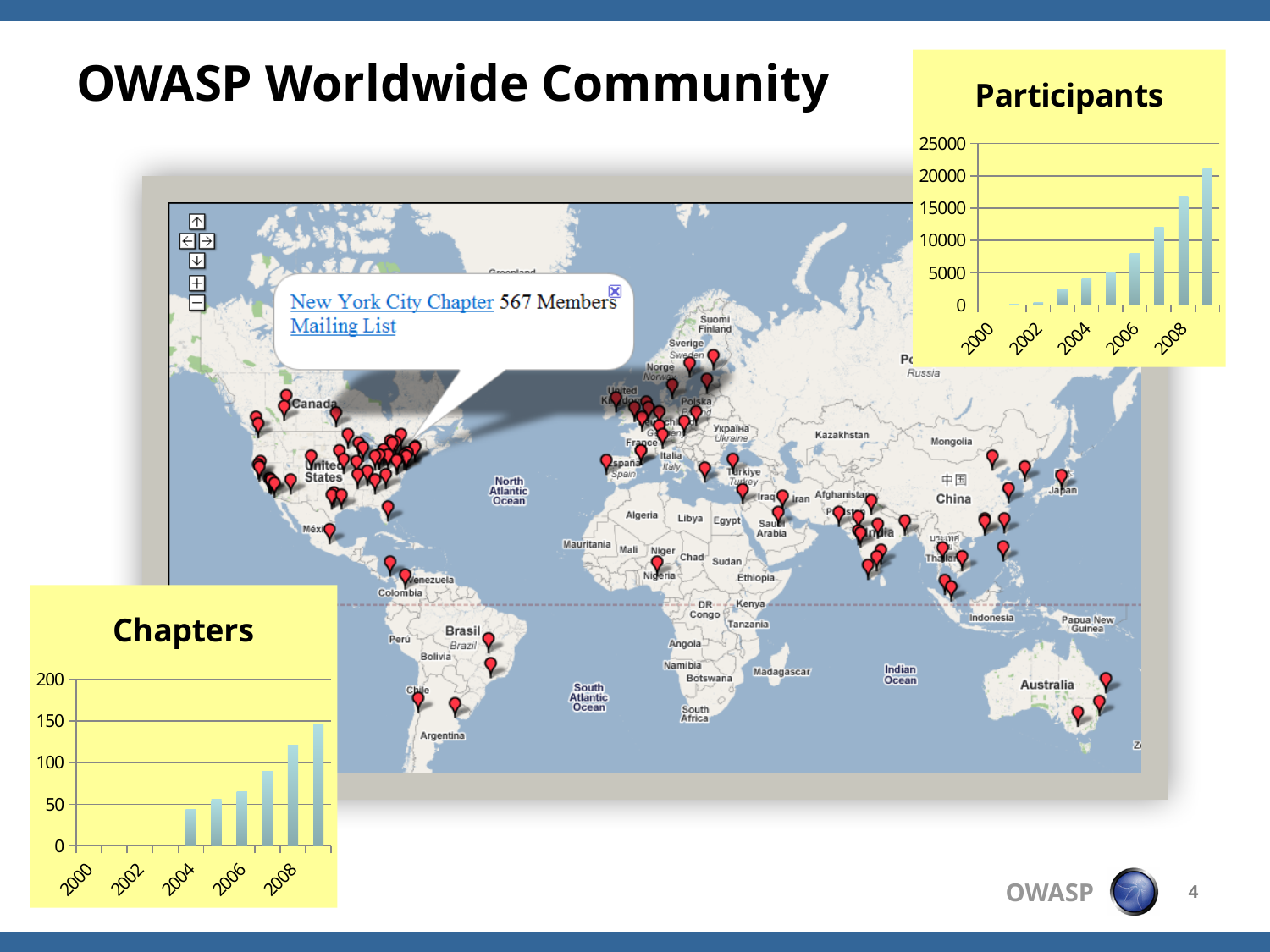
In the Chapters chart, is the value for 2006 greater or less than 100? less In the Chapters chart, do the values rise or fall across the years shown? rise What kind of chart is the Participants chart? bar chart What is the title of the chart in the top right of the slide? Participants In the Participants chart, do the values rise or fall from 2000 to the last year shown? rise In the Chapters chart, is the value for 2008 greater or less than 100? greater What is the title of the chart in the bottom left of the slide? Chapters In the Chapters chart, is the tallest bar greater or less than 100? greater What kind of chart is the Chapters chart? bar chart